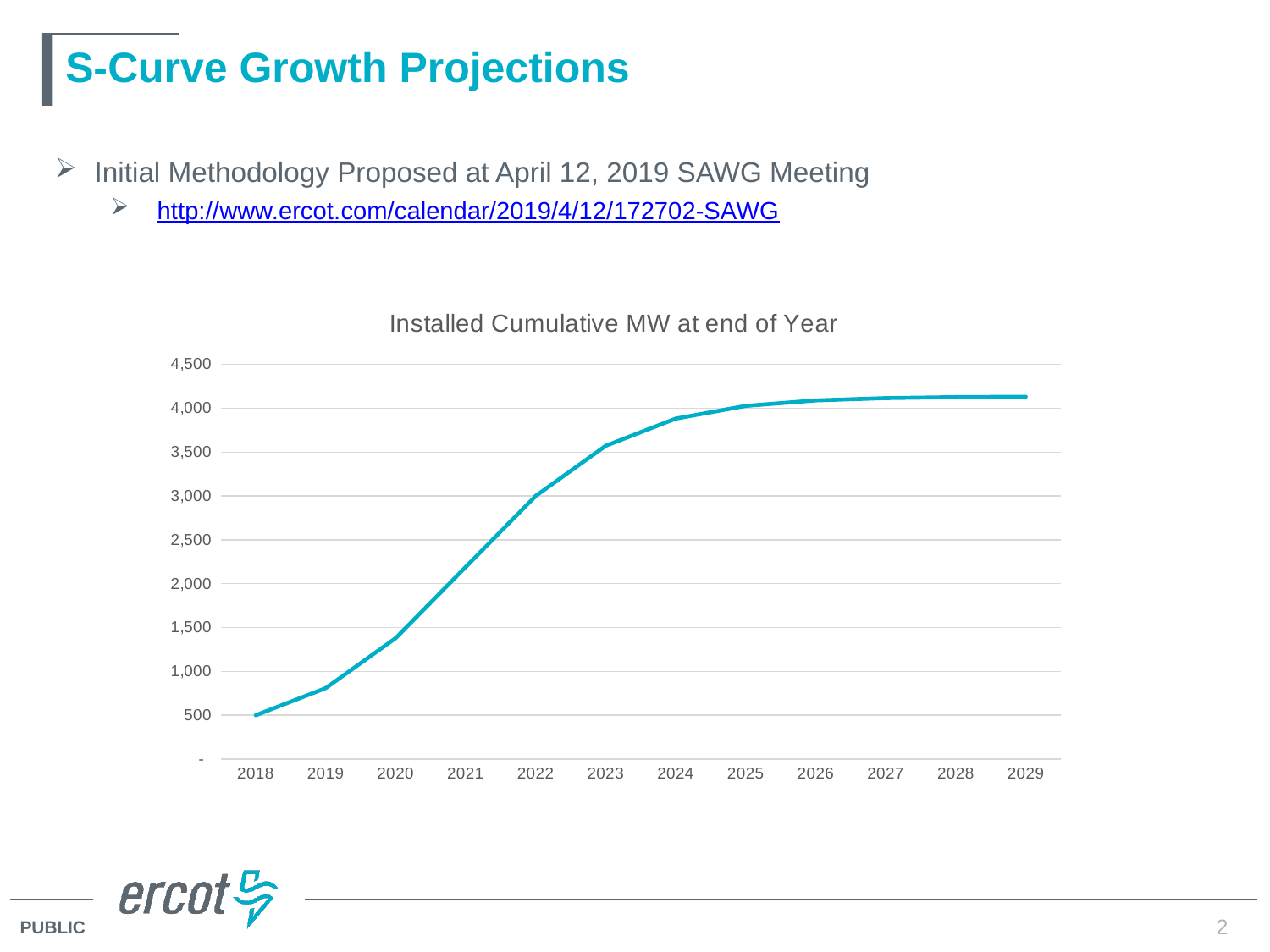
Is the value for 2021 greater or less than 2,000? greater Is the value for 2023 greater or less than 3,500? greater Which year has the lowest installed cumulative MW? 2018 How many years are plotted along the x axis of the chart? 12 What type of chart is shown on the slide? Line chart Which year has the larger value, 2020 or 2022? 2022 Is the value for 2020 greater or less than 1,500? less Do the values rise or fall from 2018 to 2029? Rise What is the title of the chart? Installed Cumulative MW at end of Year What is the installed cumulative MW value for 2018? 500